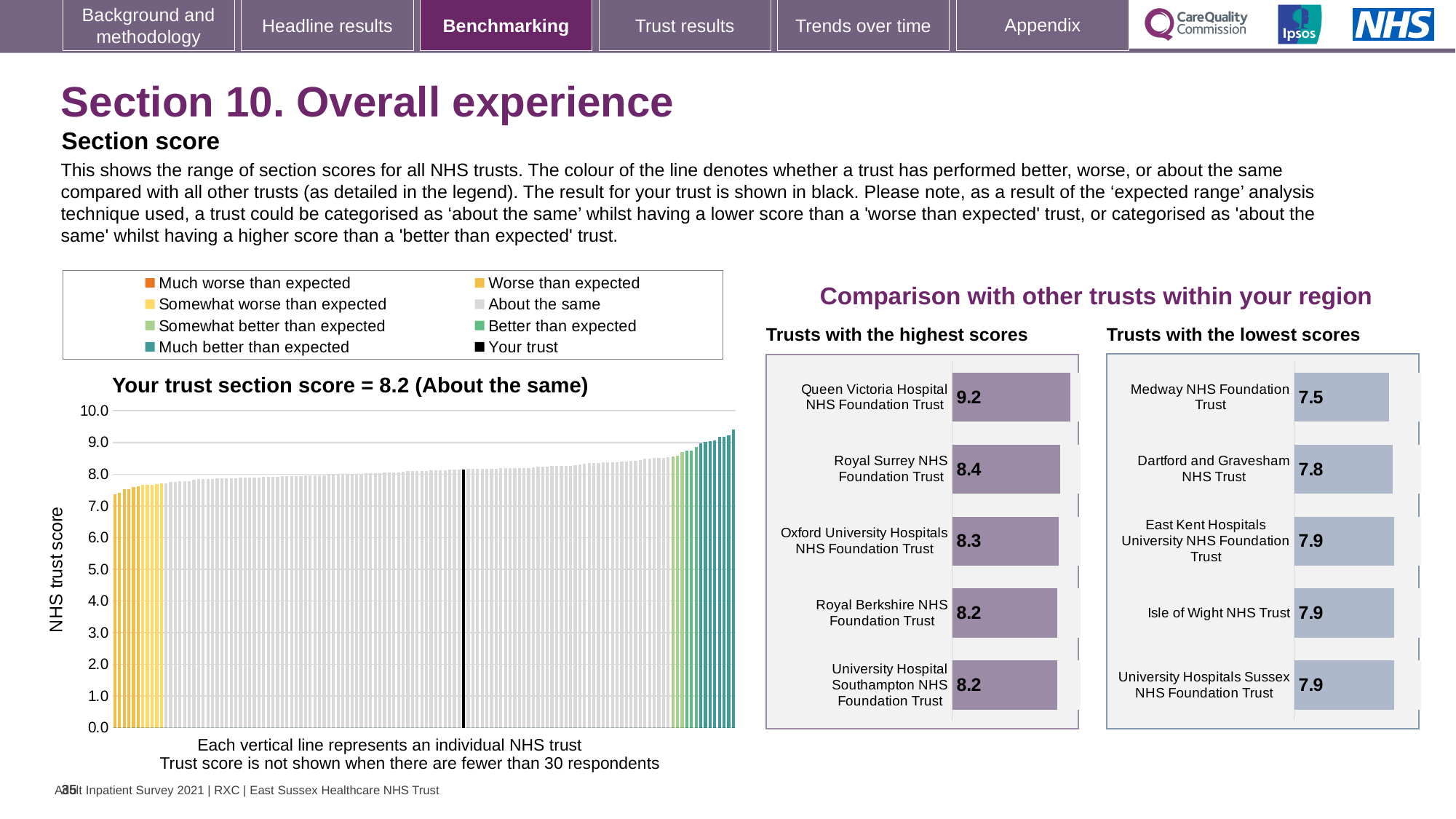
In the 'Trusts with the highest scores' chart, what is the score for Queen Victoria Hospital NHS Foundation Trust? 9.2 How many trusts are listed in the 'Trusts with the lowest scores' chart? 5 According to the title of the chart on the left, what is your trust's section score? 8.2 (About the same) In the 'Trusts with the highest scores' chart, what is the difference between the scores of Queen Victoria Hospital NHS Foundation Trust and Royal Surrey NHS Foundation Trust? 0.8 In the 'Trusts with the lowest scores' chart, what is the score for Dartford and Gravesham NHS Trust? 7.8 What kind of chart is the 'Your trust section score' chart on the left? Bar chart In the 'Trusts with the highest scores' chart, what is the score for Oxford University Hospitals NHS Foundation Trust? 8.3 In the 'Trusts with the lowest scores' chart, what is the score for Medway NHS Foundation Trust? 7.5 In the 'Trusts with the lowest scores' chart, what is the difference between the scores of Dartford and Gravesham NHS Trust and Medway NHS Foundation Trust? 0.3 In the 'Trusts with the lowest scores' chart, which trust has the lowest score? Medway NHS Foundation Trust In the 'Your trust section score' chart on the left, do the trust scores rise or fall from left to right? Rise In the 'Trusts with the highest scores' chart, which trust has the highest score? Queen Victoria Hospital NHS Foundation Trust